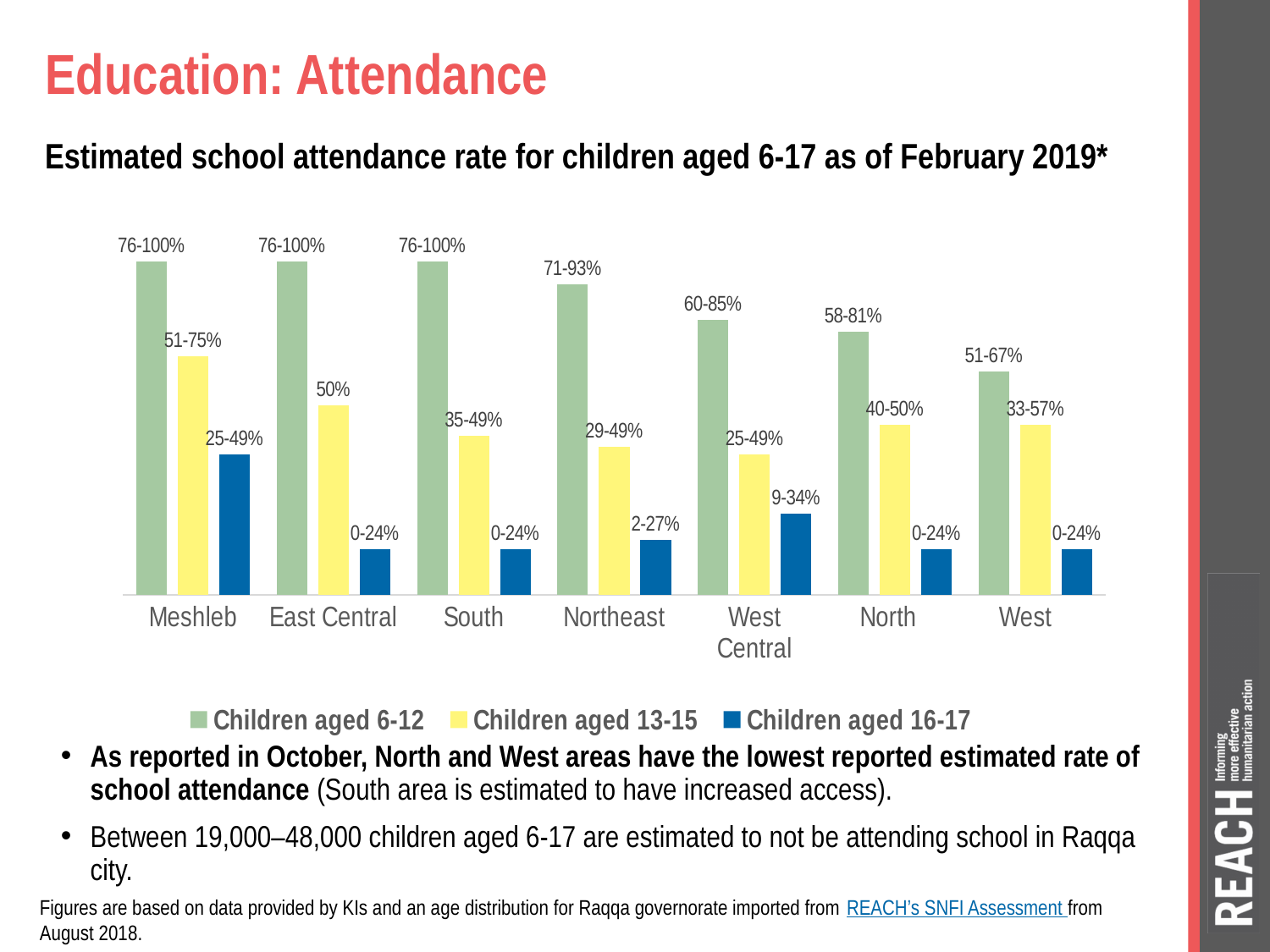
Which area has the lowest estimated attendance rate for children aged 6-12? West What is the estimated school attendance rate for children aged 6-12 in Northeast? 71-93% How many areas are shown on the x axis of the chart? 7 What is the estimated school attendance rate for children aged 13-15 in North? 40-50% What is the estimated school attendance rate for children aged 6-12 in West? 51-67% For children aged 6-12, is the attendance rate higher in South or in North? South Which area has the highest estimated attendance rate for children aged 13-15? Meshleb Which area has the highest estimated attendance rate for children aged 16-17? Meshleb How many series does the chart legend list? 3 What is the estimated school attendance rate for children aged 13-15 in East Central? 50% What is the estimated school attendance rate for children aged 16-17 in West Central? 9-34% What type of chart is used to show the estimated school attendance rates? Bar chart